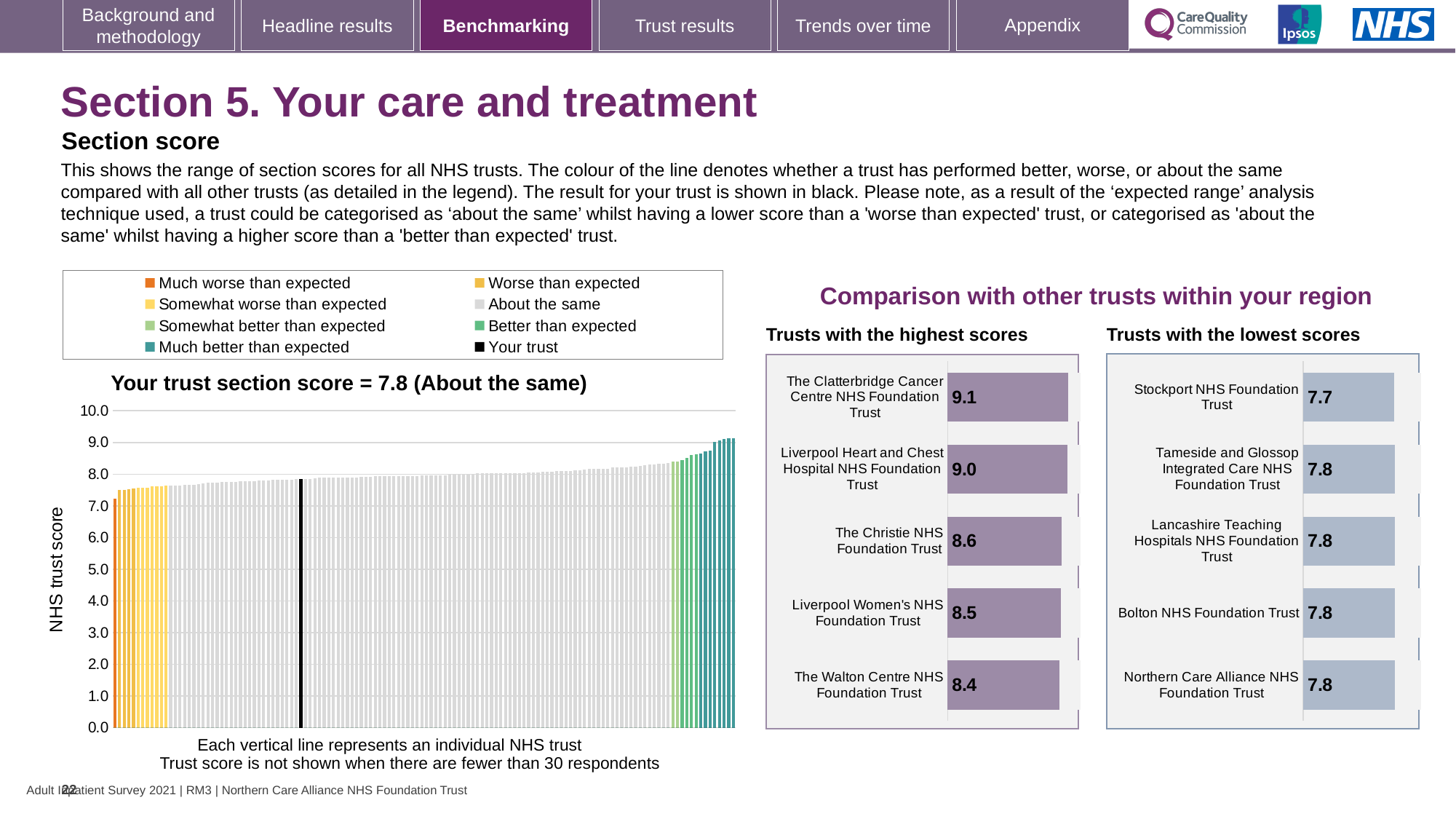
In the 'Trusts with the highest scores' chart, what is the difference between the scores of The Clatterbridge Cancer Centre NHS Foundation Trust and The Walton Centre NHS Foundation Trust? 0.7 What kind of chart is the 'Trusts with the highest scores' chart? Bar chart How many trusts are listed in the 'Trusts with the lowest scores' chart? 5 What is the label on the vertical axis of the main chart on the left? NHS trust score In the 'Trusts with the highest scores' chart, what is the score for The Clatterbridge Cancer Centre NHS Foundation Trust? 9.1 In the 'Trusts with the highest scores' chart, which trust has the highest score? The Clatterbridge Cancer Centre NHS Foundation Trust What is the section score for your trust shown in the title of the main chart on the left? 7.8 In the 'Trusts with the lowest scores' chart, what is the score for Stockport NHS Foundation Trust? 7.7 In the 'Trusts with the highest scores' chart, what is the score for The Walton Centre NHS Foundation Trust? 8.4 How many entries does the legend of the main chart on the left list? 8 In the 'Trusts with the lowest scores' chart, which trust has the lowest score? Stockport NHS Foundation Trust In the 'Trusts with the highest scores' chart, which has the higher score: The Christie NHS Foundation Trust or Liverpool Women's NHS Foundation Trust? The Christie NHS Foundation Trust